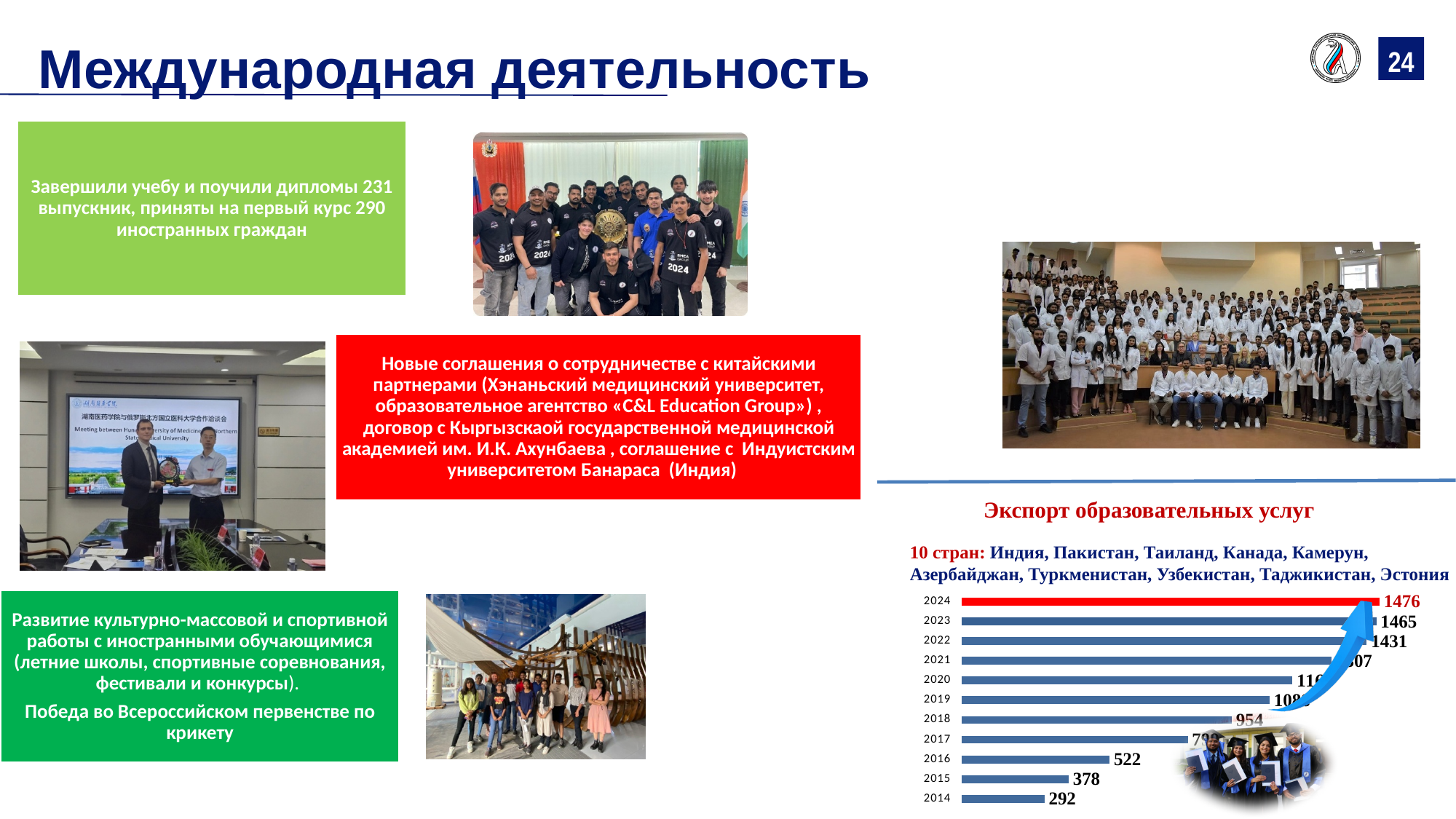
Do the values in the "Экспорт образовательных услуг" chart rise or fall from 2014 to 2024? rise How many years are shown in the "Экспорт образовательных услуг" chart? 11 What is the value for 2022 in the "Экспорт образовательных услуг" chart? 1431 What is the value for 2014 in the "Экспорт образовательных услуг" chart? 292 Which year has the lowest value in the "Экспорт образовательных услуг" chart? 2014 In the "Экспорт образовательных услуг" chart, which is larger: the value for 2018 or the value for 2016? 2018 What is the value for 2024 in the "Экспорт образовательных услуг" chart? 1476 In the "Экспорт образовательных услуг" chart, what is the difference between the values for 2016 and 2015? 144 What type of chart is shown under the title "Экспорт образовательных услуг"? bar chart What is the value for 2018 in the "Экспорт образовательных услуг" chart? 954 In the "Экспорт образовательных услуг" chart, what is the difference between the values for 2024 and 2023? 11 Which year has the highest value in the "Экспорт образовательных услуг" chart? 2024